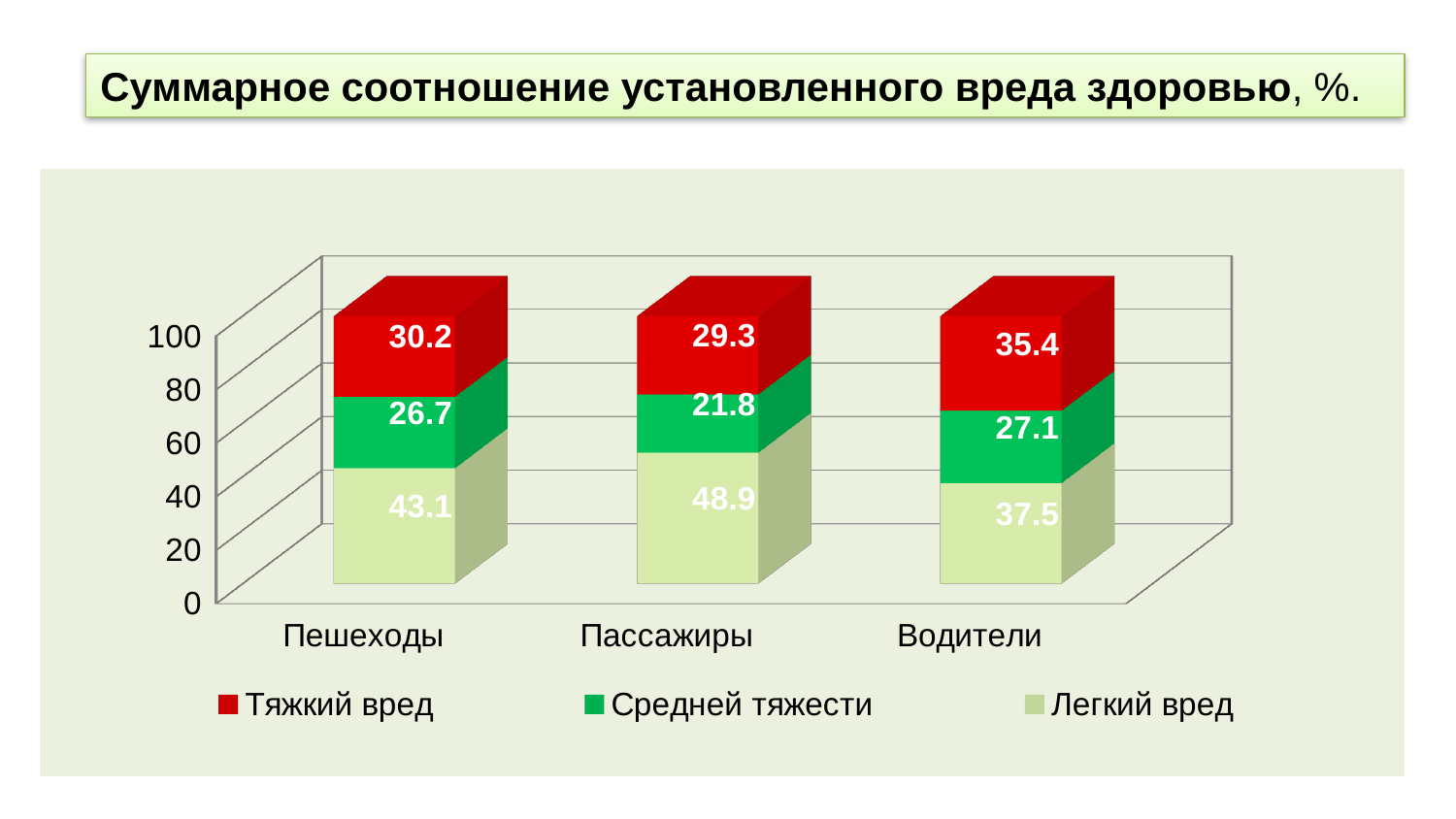
What is the value of Тяжкий вред for Водители? 35.4 Which is larger: Тяжкий вред for Пешеходы or Тяжкий вред for Пассажиры? Пешеходы What kind of chart is shown on the slide? Stacked bar chart Which series is shown in red in the legend? Тяжкий вред What is the value of Средней тяжести for Пешеходы? 26.7 What is the value of Легкий вред for Пассажиры? 48.9 How many categories are shown on the x axis? 3 What is the difference between the Легкий вред values for Пассажиры and Водители? 11.4 How many series does the legend list? 3 Which category has the lowest value for Средней тяжести? Пассажиры What is the total of the stacked bar for Водители? 100.0 Which category has the highest value for Легкий вред? Пассажиры